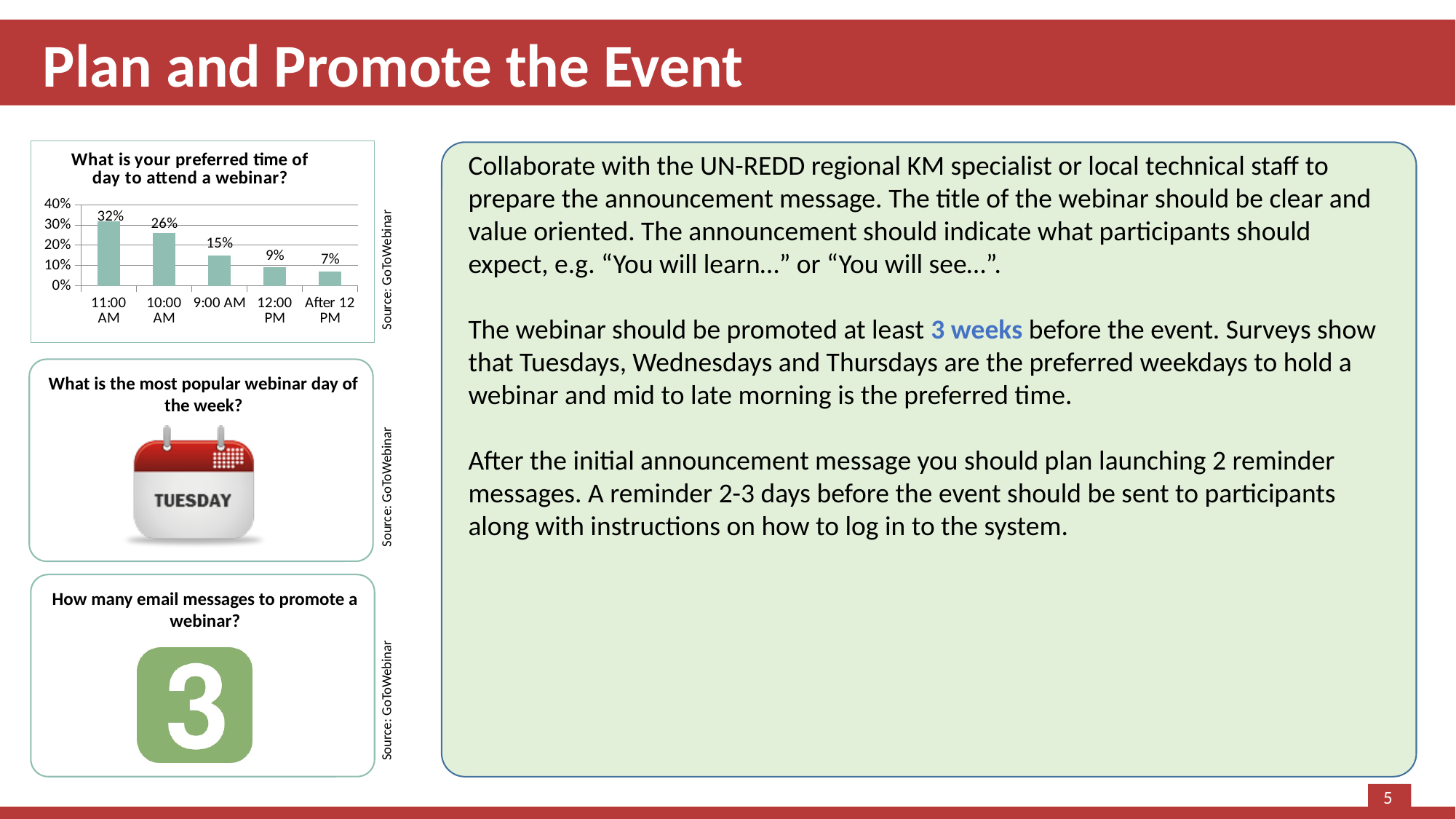
Which time of day has the lowest value in the preferred time of day chart? After 12 PM What is the difference between the values for 11:00 AM and 10:00 AM in the preferred time of day chart? 6% Do the values in the preferred time of day chart rise or fall from left to right along the x axis? Fall Which time of day has the highest value in the preferred time of day chart? 11:00 AM What is the title of the bar chart on the slide? What is your preferred time of day to attend a webinar? What is the value for After 12 PM in the preferred time of day chart? 7% What is the value for 9:00 AM in the preferred time of day chart? 15% What is the difference between the values for 9:00 AM and 12:00 PM in the preferred time of day chart? 6% Which is larger in the preferred time of day chart, the value for 10:00 AM or the value for 12:00 PM? 10:00 AM What is the value for 11:00 AM in the preferred time of day chart? 32% How many time-of-day categories are shown in the preferred time of day chart? 5 What kind of chart is the preferred time of day chart? Bar chart